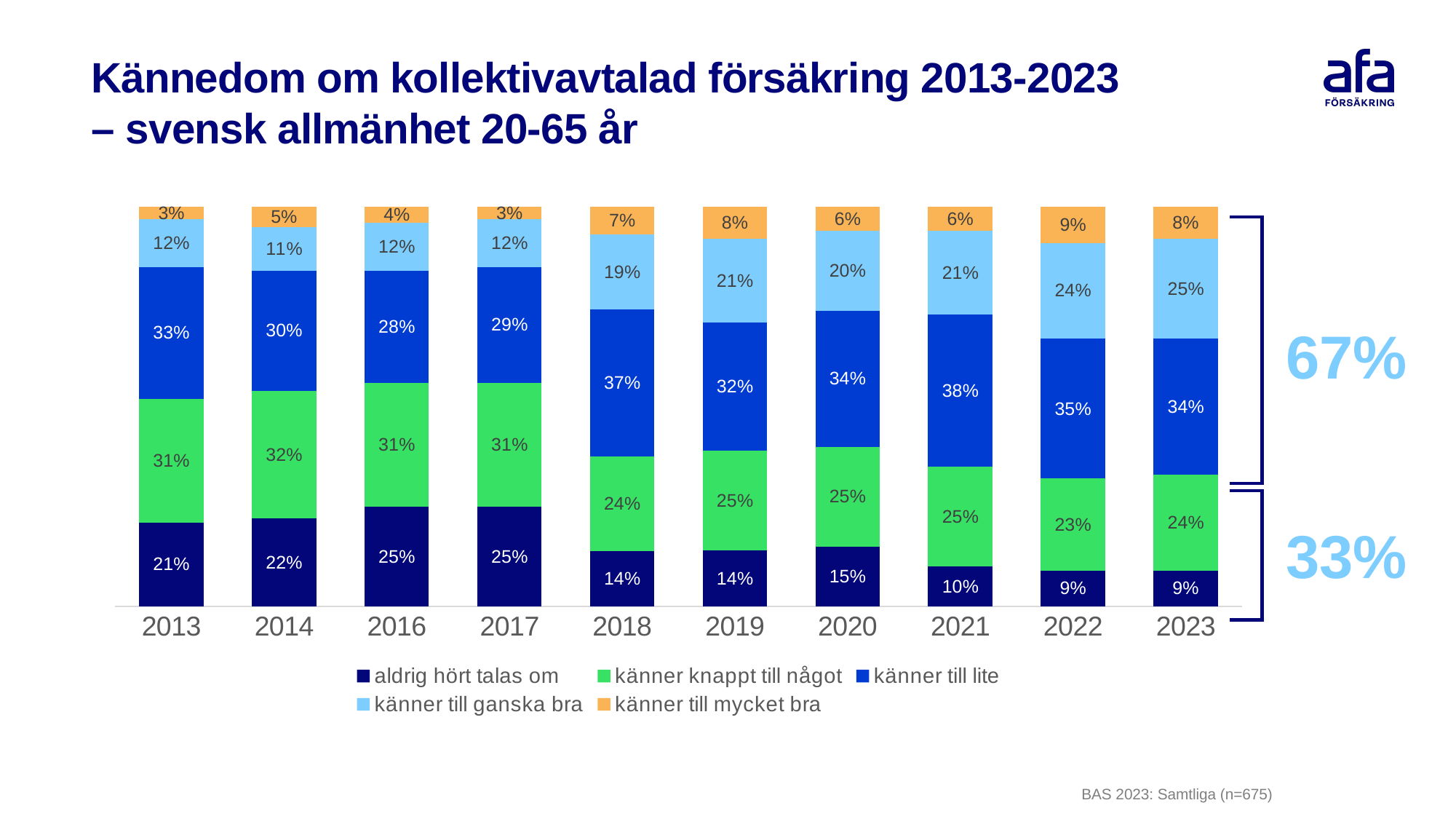
How many series does the legend list? 5 Which year has the larger "känner till lite" share, 2018 or 2019? 2018 In which year is the "känner till mycket bra" share the highest? 2022 What kind of chart is shown on the slide? Stacked bar chart What is the total of the stacked bar for 2023? 100% By how many percentage points did "aldrig hört talas om" fall from 2013 to 2023? 12 percentage points In which year is the "känner till lite" share the highest? 2021 How many years are shown on the x axis? 10 What is the value for "känner till ganska bra" in 2022? 24% What is the value for "känner till lite" in 2018? 37% In which year is the "känner knappt till något" share the lowest? 2022 What percentage of respondents answered "aldrig hört talas om" in 2023? 9%